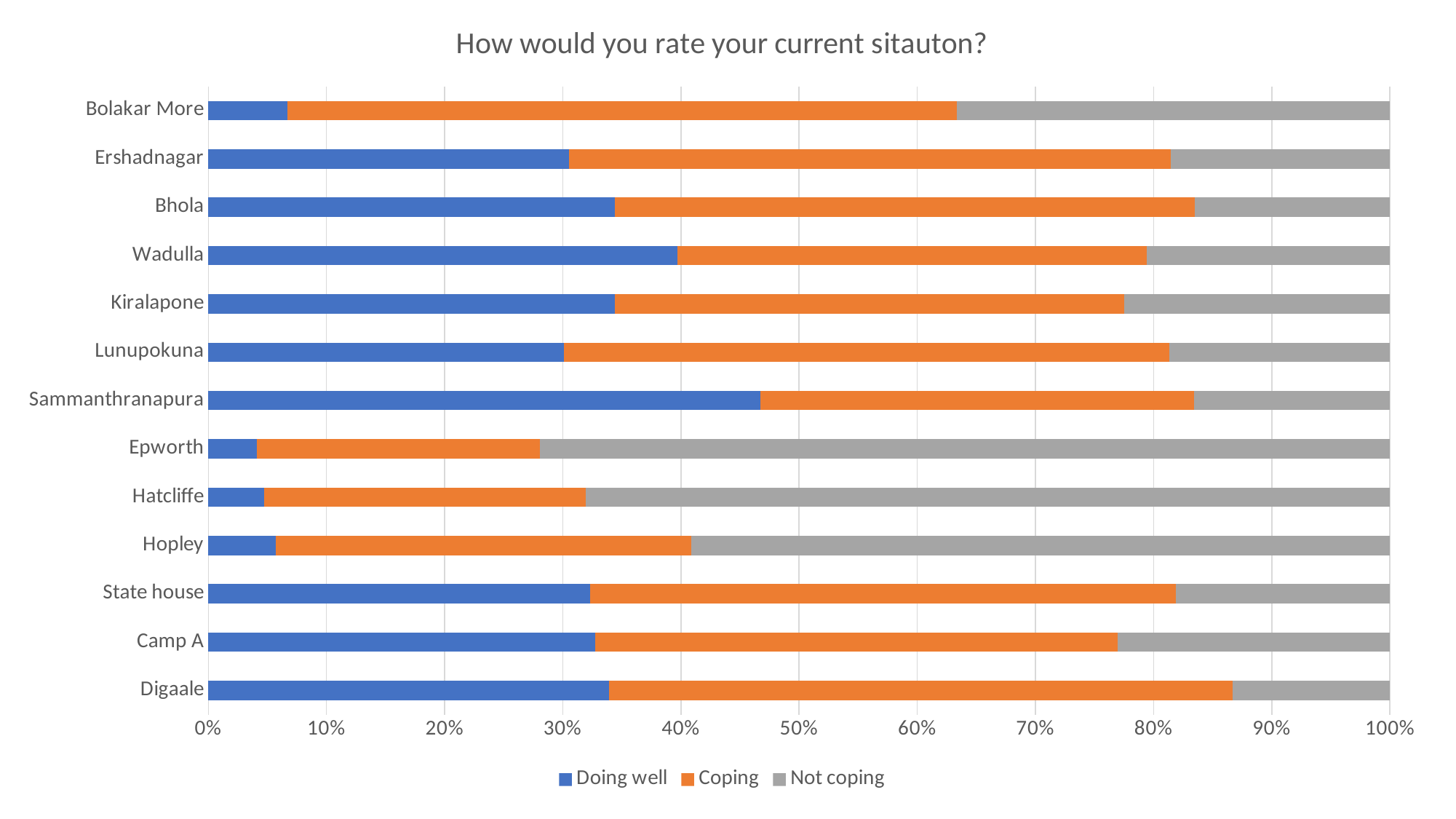
How many locations (categories) are plotted on the chart? 13 What kind of chart is shown on the slide? Stacked bar chart Which location has the largest 'Not coping' share? Epworth How many series does the legend list? 3 Is the 'Doing well' value for Sammanthranapura greater or less than 40%? greater Which location has the largest 'Doing well' share? Sammanthranapura Which has a larger 'Not coping' share, Epworth or Hopley? Epworth Which has a larger 'Doing well' share, Wadulla or Bhola? Wadulla Is the 'Doing well' value for Digaale greater or less than 30%? greater Which series is shown in orange in the legend? Coping What is the title of the chart? How would you rate your current sitauton? Is the 'Doing well' value for Bolakar More greater or less than 10%? less